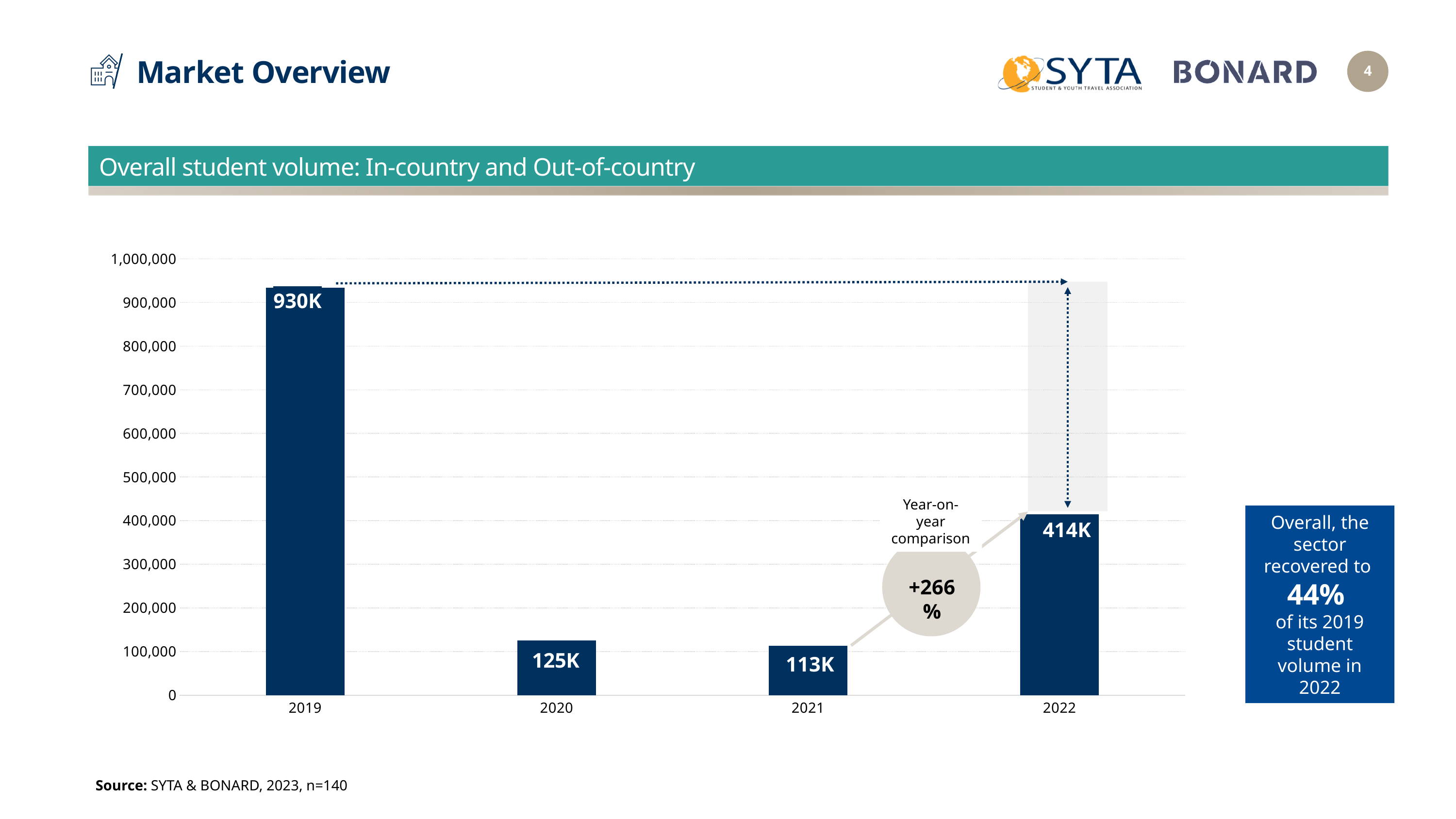
What is the overall student volume for 2019? 930K What is the overall student volume for 2020? 125K Which year has the lowest overall student volume? 2021 What year-on-year percentage change is annotated between 2021 and 2022? +266% What is the overall student volume for 2022? 414K What is the difference in student volume between 2019 and 2022? 516K What kind of chart is used to show overall student volume? bar chart What is the overall student volume for 2021? 113K Is the student volume for 2022 greater or less than 400,000? greater Which year has the highest overall student volume? 2019 How many years are shown on the x axis of the chart? 4 Which year has a larger student volume, 2020 or 2022? 2022